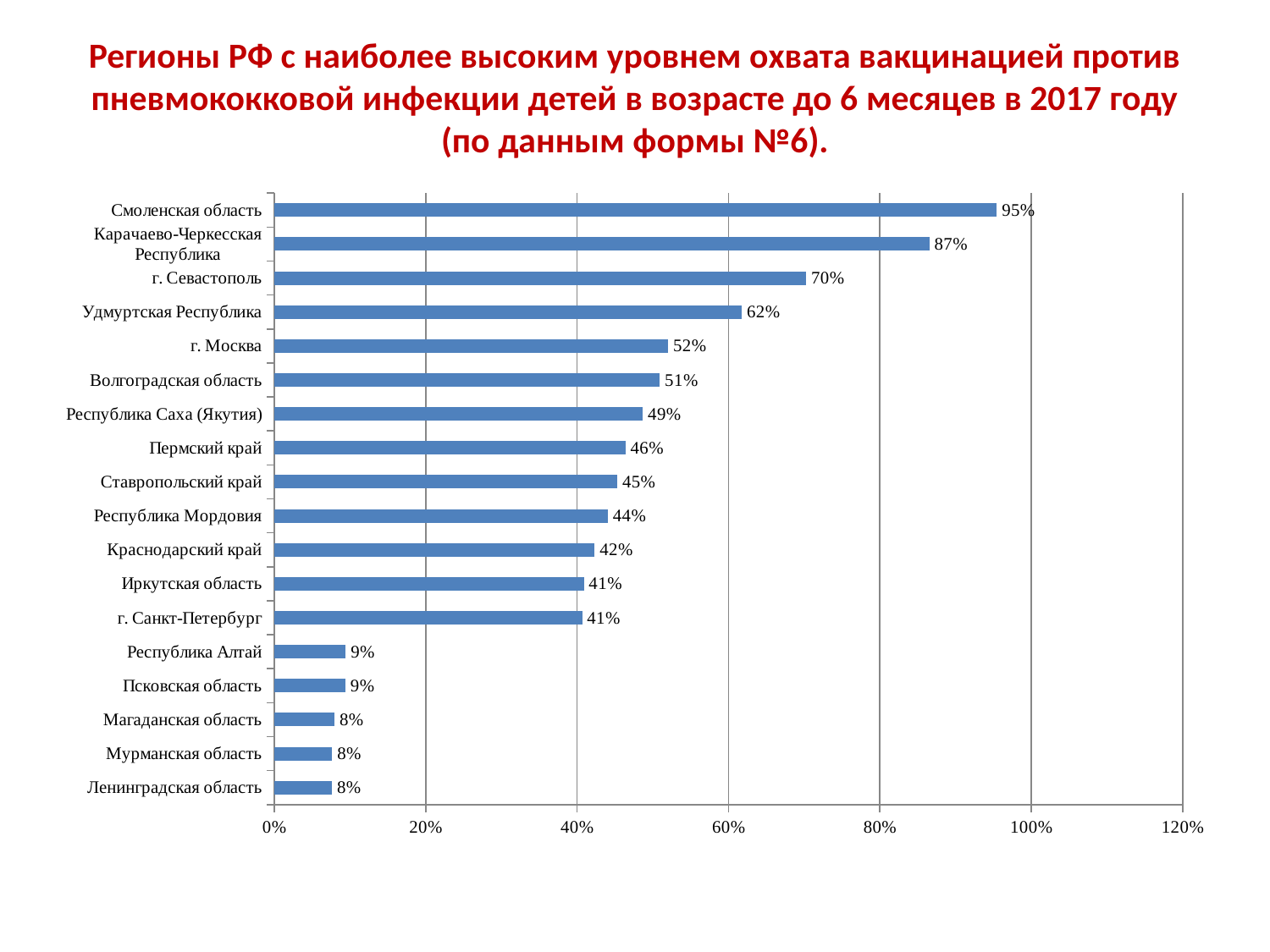
How many regions are shown in the chart? 18 What is the maximum value shown on the horizontal axis? 120% What kind of chart is shown on the slide? bar chart Which is larger, the value for Удмуртская Республика or the value for Волгоградская область? Удмуртская Республика Which region has the highest value? Смоленская область Is the value for Ставропольский край greater or less than 40%? greater Is the value for Псковская область greater or less than 20%? less What is the value for г. Севастополь? 70% What is the difference between Смоленская область and Карачаево-Черкесская Республика? 8% What is the value for Республика Мордовия? 44% What is the difference between г. Москва and Пермский край? 6% What is the value for Смоленская область? 95%